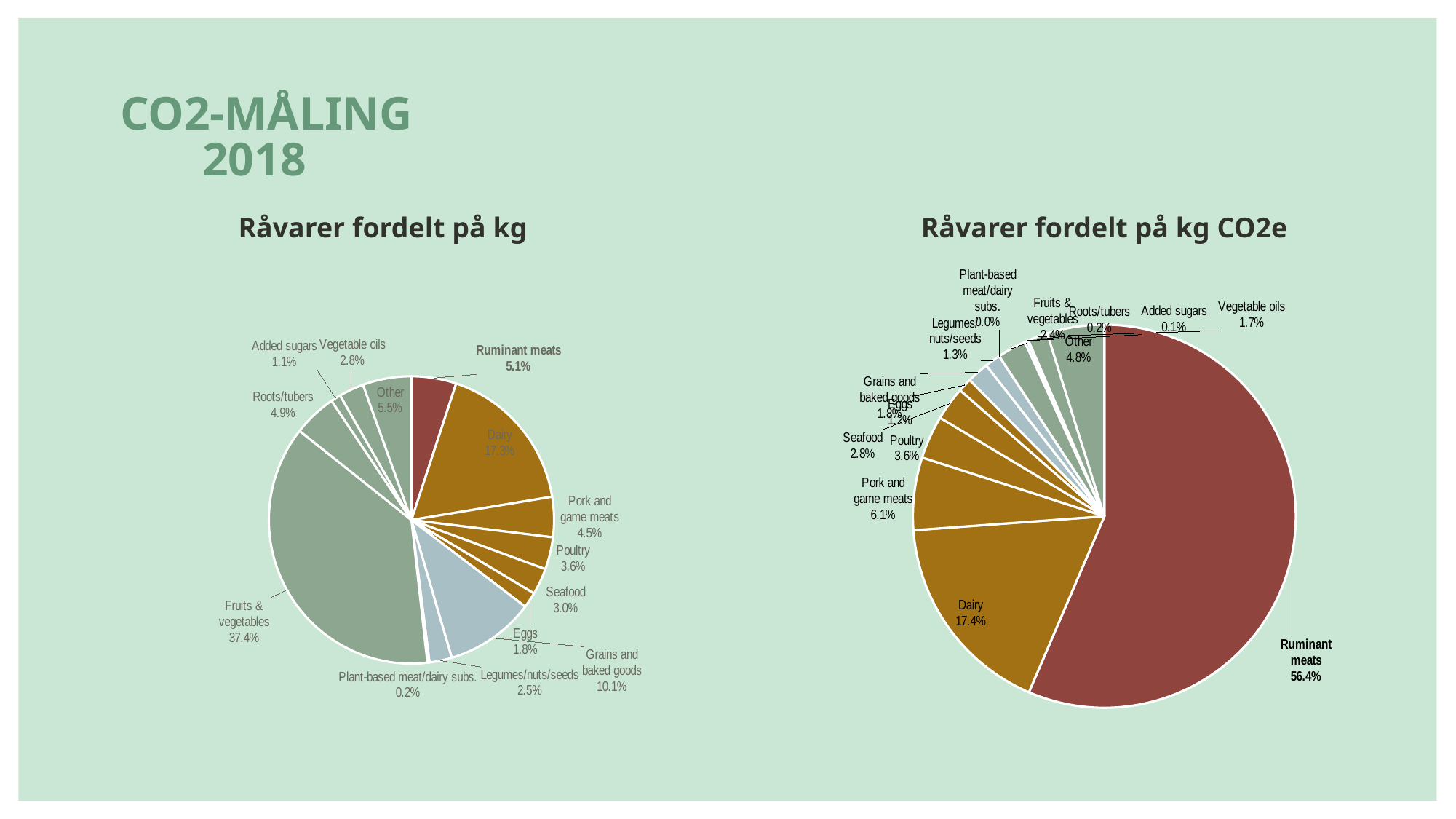
In the chart titled "Råvarer fordelt på kg CO2e", what is the difference between Ruminant meats and Dairy? 39.0% In the chart titled "Råvarer fordelt på kg CO2e", what share does Ruminant meats have? 56.4% In the chart titled "Råvarer fordelt på kg", what is the value for Grains and baked goods? 10.1% In the chart titled "Råvarer fordelt på kg CO2e", what is the value for Pork and game meats? 6.1% In the chart titled "Råvarer fordelt på kg", what share does Fruits & vegetables have? 37.4% What kind of chart is the chart titled "Råvarer fordelt på kg CO2e"? Pie chart In the chart titled "Råvarer fordelt på kg", what is the difference between Fruits & vegetables and Dairy? 20.1% In the chart titled "Råvarer fordelt på kg", what is the value for Roots/tubers? 4.9% In the chart titled "Råvarer fordelt på kg CO2e", which category has the largest slice? Ruminant meats In the chart titled "Råvarer fordelt på kg", which is larger, Dairy or Ruminant meats? Dairy In the chart titled "Råvarer fordelt på kg", which category has the largest slice? Fruits & vegetables In the chart titled "Råvarer fordelt på kg", which category has the smallest slice? Plant-based meat/dairy subs.